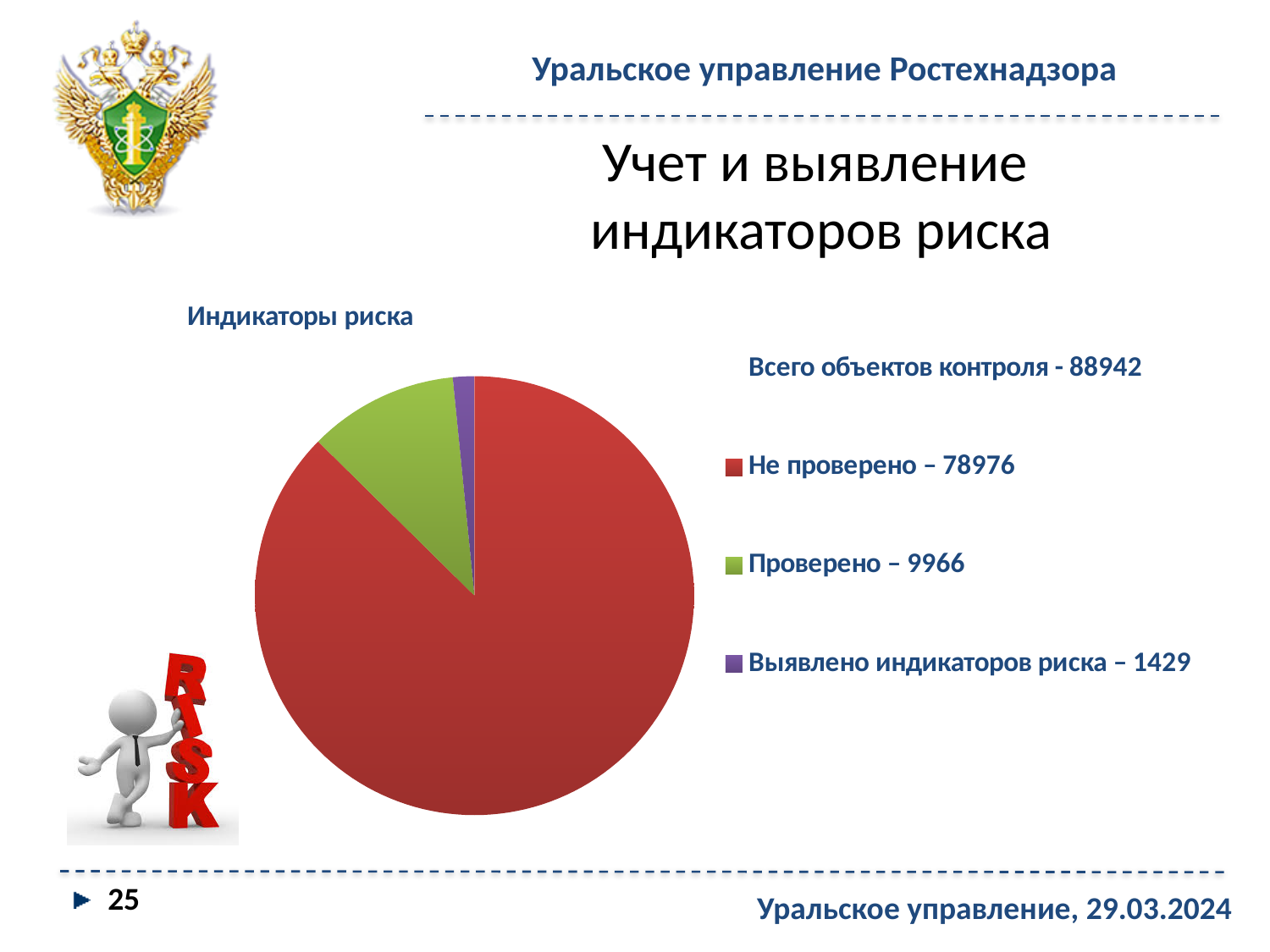
What is the difference between "Не проверено" and "Проверено"? 69010 What is the value for "Проверено"? 9966 What colour is the slice for "Проверено"? Green How many slices does the pie chart have? 3 What is the difference between "Проверено" and "Выявлено индикаторов риска"? 8537 Which category has the largest slice of the pie? Не проверено Which category has the smallest slice of the pie? Выявлено индикаторов риска Which is larger, "Проверено" or "Выявлено индикаторов риска"? Проверено What kind of chart is shown on the slide? Pie chart What is the value for "Не проверено"? 78976 What is the value for "Выявлено индикаторов риска"? 1429 What is the title of the chart? Индикаторы риска